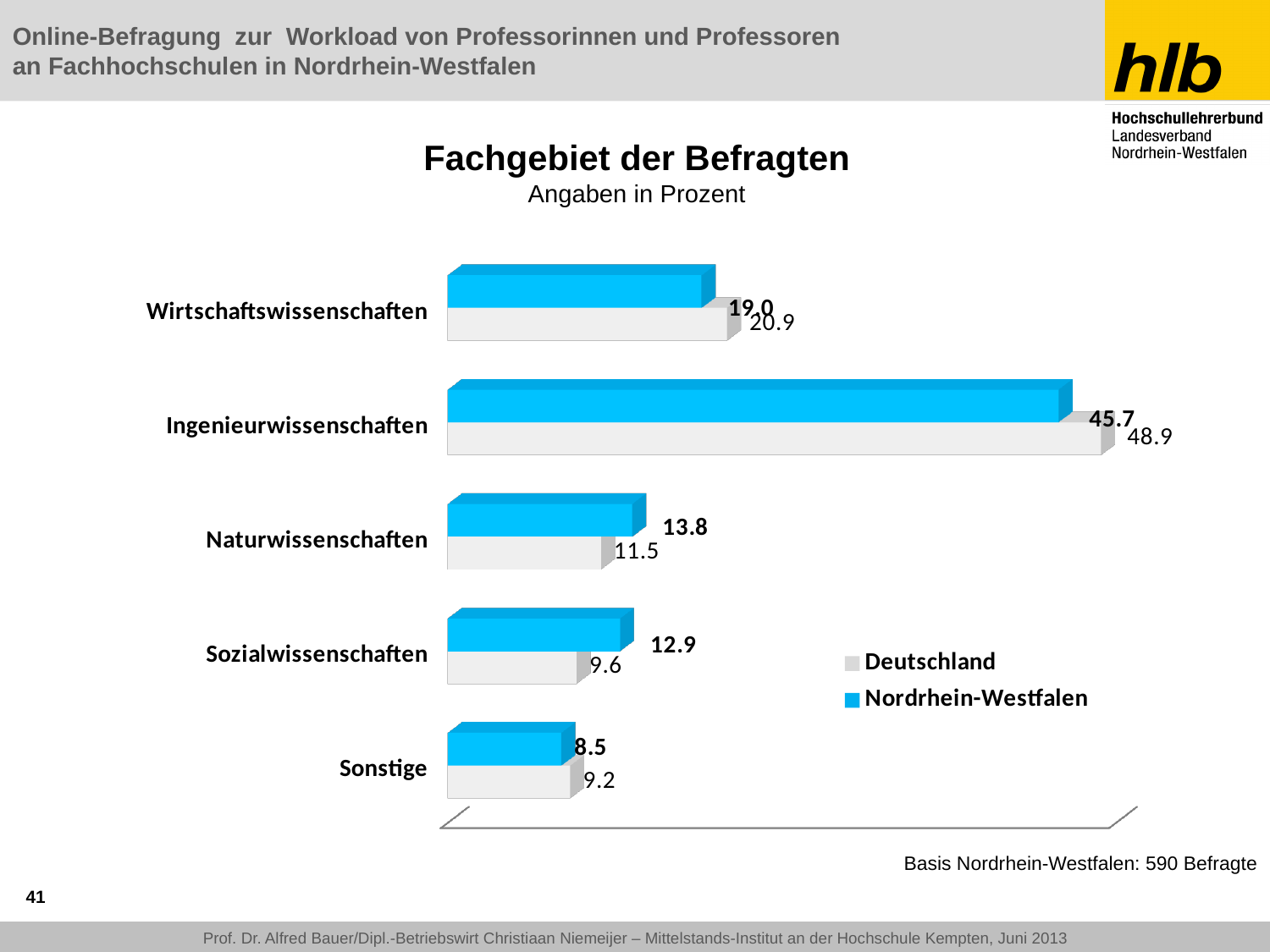
What is the value for Nordrhein-Westfalen in Naturwissenschaften? 13.8 How many series does the legend list? 2 Which category has the highest value for Nordrhein-Westfalen? Ingenieurwissenschaften What is the value for Deutschland in Ingenieurwissenschaften? 48.9 What is the value for Deutschland in Sozialwissenschaften? 9.6 Which is larger for Naturwissenschaften: the Deutschland value or the Nordrhein-Westfalen value? Nordrhein-Westfalen What kind of chart is shown on the slide? bar chart Which category has the lowest value for Nordrhein-Westfalen? Sonstige How many categories (Fachgebiete) are shown in the chart? 5 What is the difference between the Deutschland and Nordrhein-Westfalen values for Ingenieurwissenschaften? 3.2 What is the title of the chart? Fachgebiet der Befragten What is the value for Nordrhein-Westfalen in Ingenieurwissenschaften? 45.7